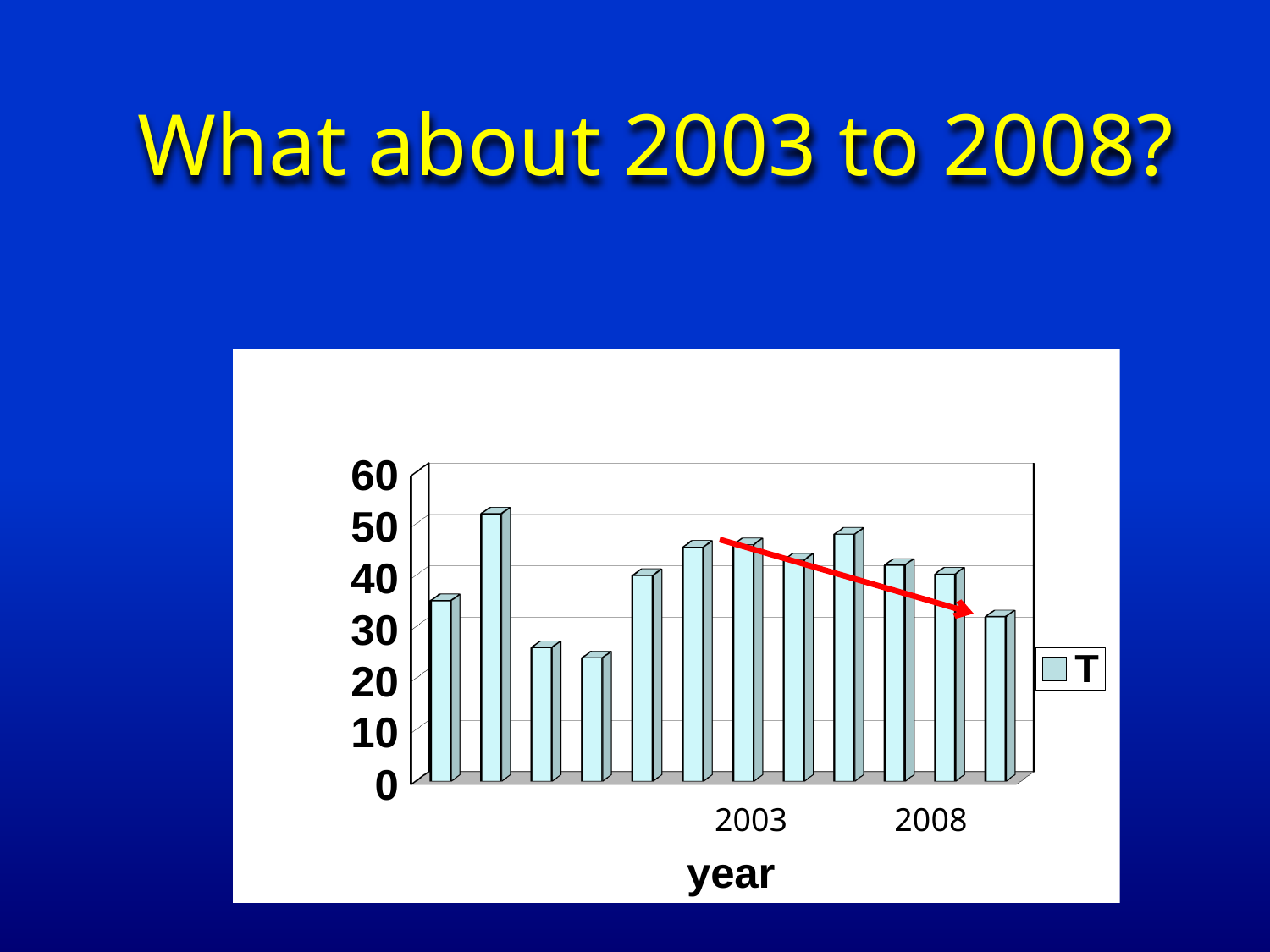
Is the value for 2003 greater or less than 40? greater Do the values rise or fall from 2003 to 2008? fall What is the title of the x axis? year Is the value of the last (rightmost) bar greater or less than 40? less Is the value of the shortest bar greater or less than 30? less What kind of chart is shown on the slide? bar chart How many bars are plotted in the chart? 12 How many series does the legend list? 1 What is the name of the series shown in the legend? T What is the highest value shown on the y axis? 60 Which is larger, the first bar or the second bar? the second bar